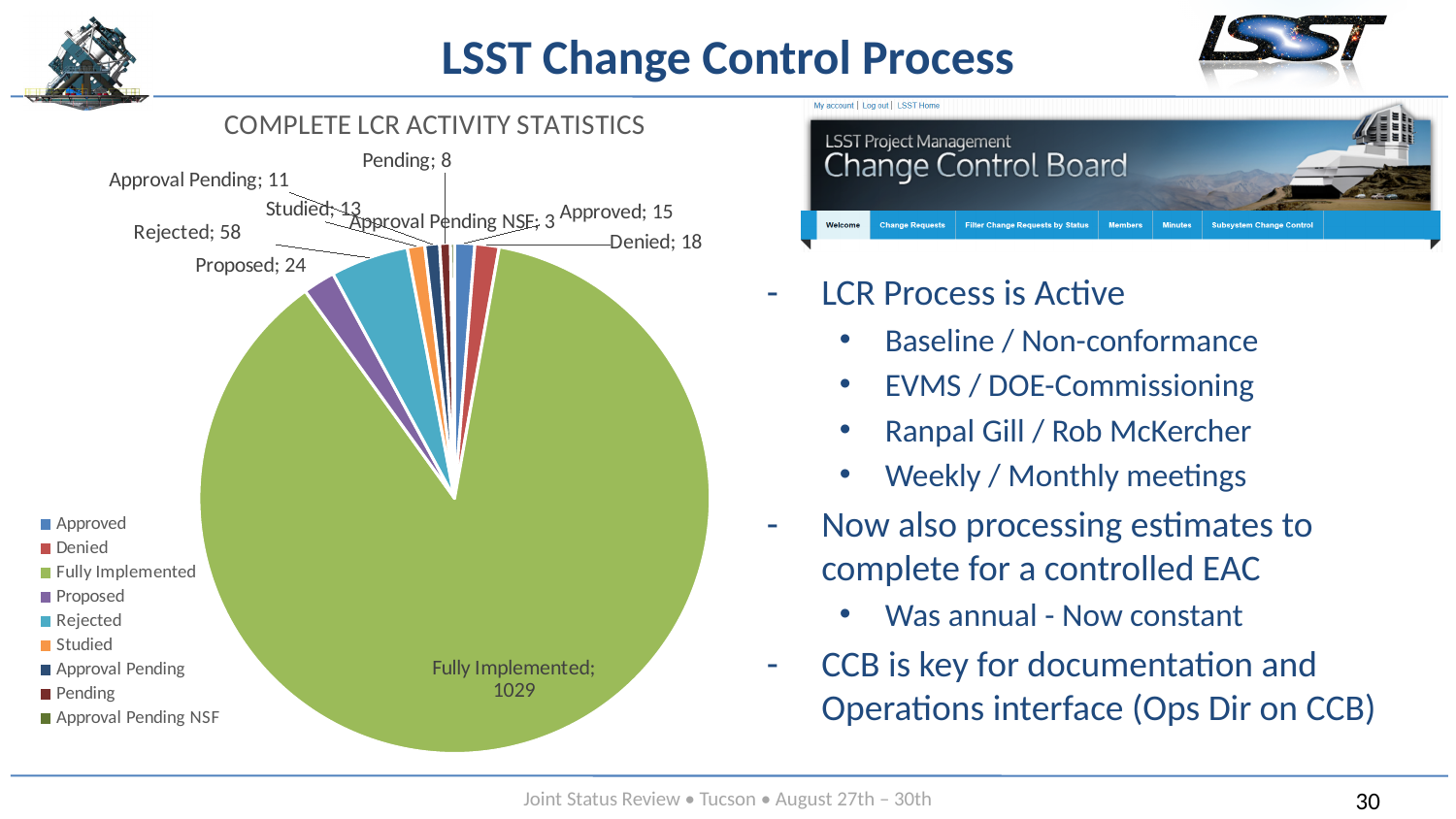
What is the value for Fully Implemented? 1029 Which is larger, Approved or Denied? Denied What is the value for Denied? 18 What is the value for Rejected? 58 How many categories does the legend of the pie chart list? 9 What is the difference between the Rejected and Proposed values? 34 Which category has the largest slice of the pie? Fully Implemented What is the total of all the values shown in the pie chart? 1179 What kind of chart is shown on the slide? Pie chart Which category has the smallest value? Approval Pending NSF What is the value for Approval Pending NSF? 3 What is the title of the chart? COMPLETE LCR ACTIVITY STATISTICS